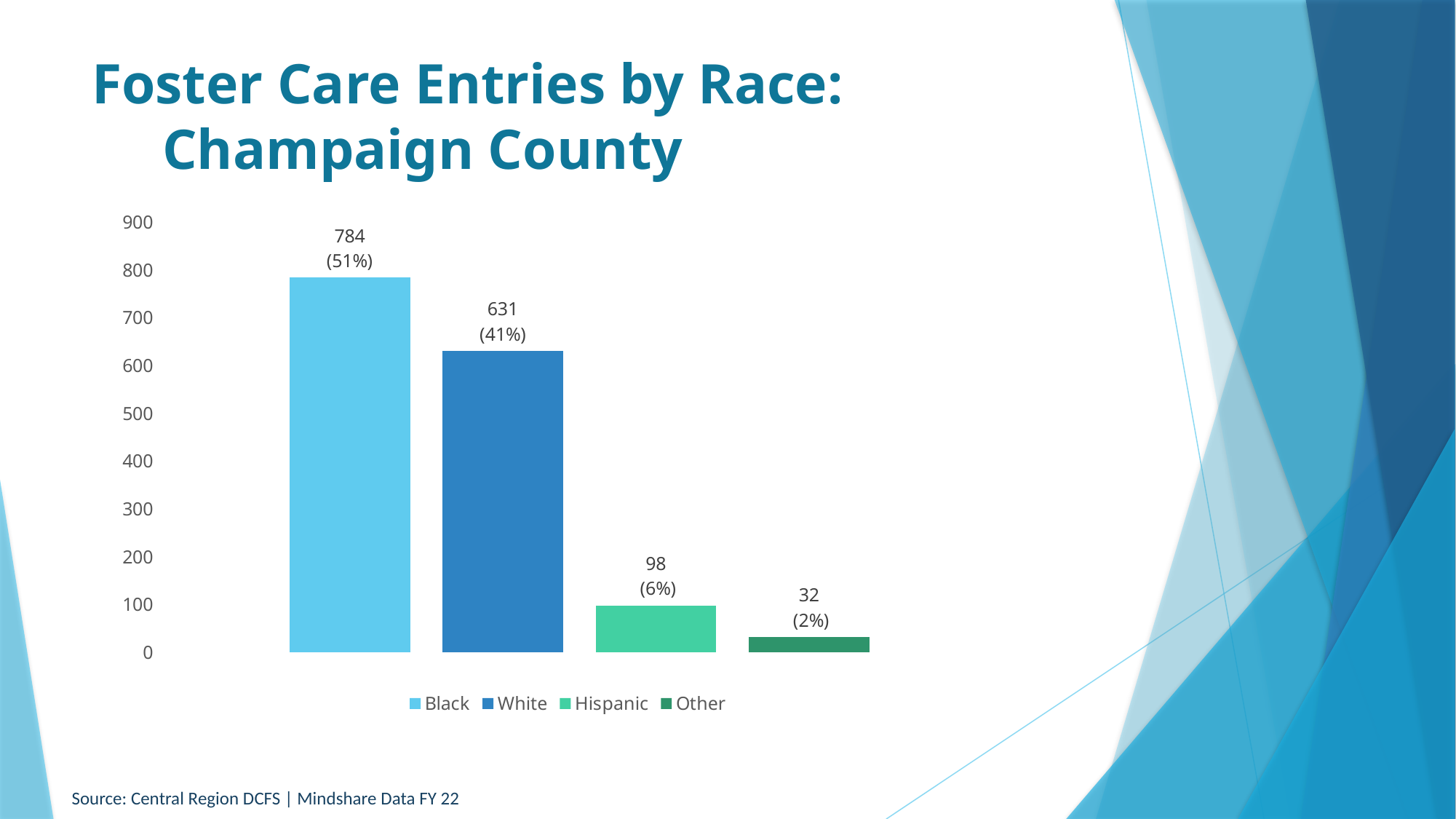
What kind of chart is shown on the slide? Bar chart What is the number of foster care entries for Black children? 784 What is the number of foster care entries for the Other category? 32 What percentage of foster care entries is shown for Hispanic children? 6% Which race category has the highest number of foster care entries? Black Which race category has the lowest number of foster care entries? Other How many race categories are shown in the chart? 4 What is the difference in foster care entries between Black and White children? 153 What is the number of foster care entries for White children? 631 What is the source cited for the chart data? Central Region DCFS | Mindshare Data FY 22 Is the value for White greater or less than 600? greater Which has more foster care entries, Hispanic or Other? Hispanic